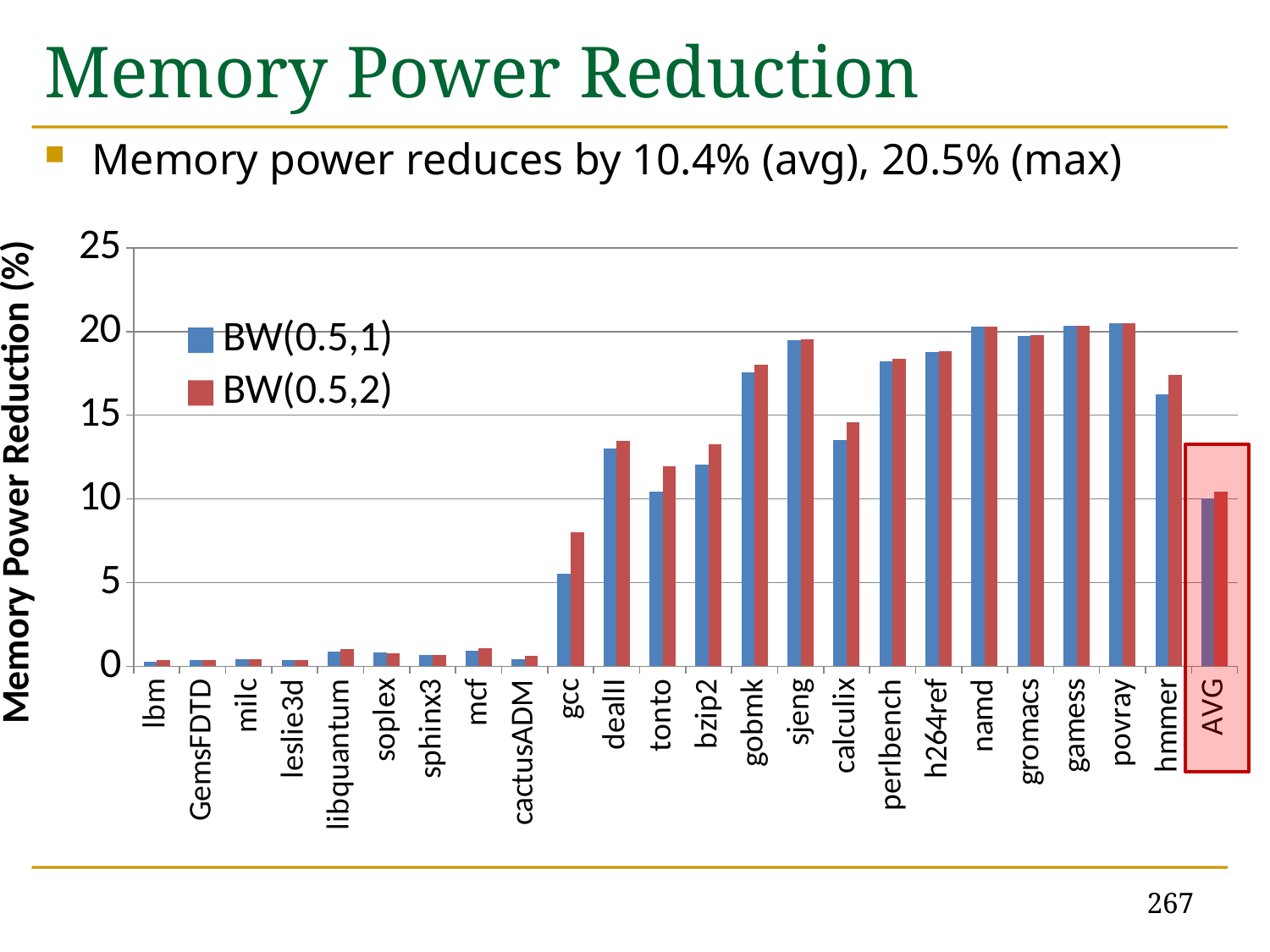
Do the values generally rise or fall moving from left to right across the benchmarks? rise How many categories are shown along the x axis, including AVG? 24 Is the BW(0.5,1) value for calculix greater or less than 15? less What is the label of the y axis? Memory Power Reduction (%) For gcc, which series has the larger value, BW(0.5,1) or BW(0.5,2)? BW(0.5,2) Is the BW(0.5,2) value for dealII greater or less than 10? greater How many series does the legend list? 2 Is the BW(0.5,1) value for hmmer greater or less than 15? greater What kind of chart is shown on the slide? bar chart Which has the larger BW(0.5,1) value, hmmer or povray? povray